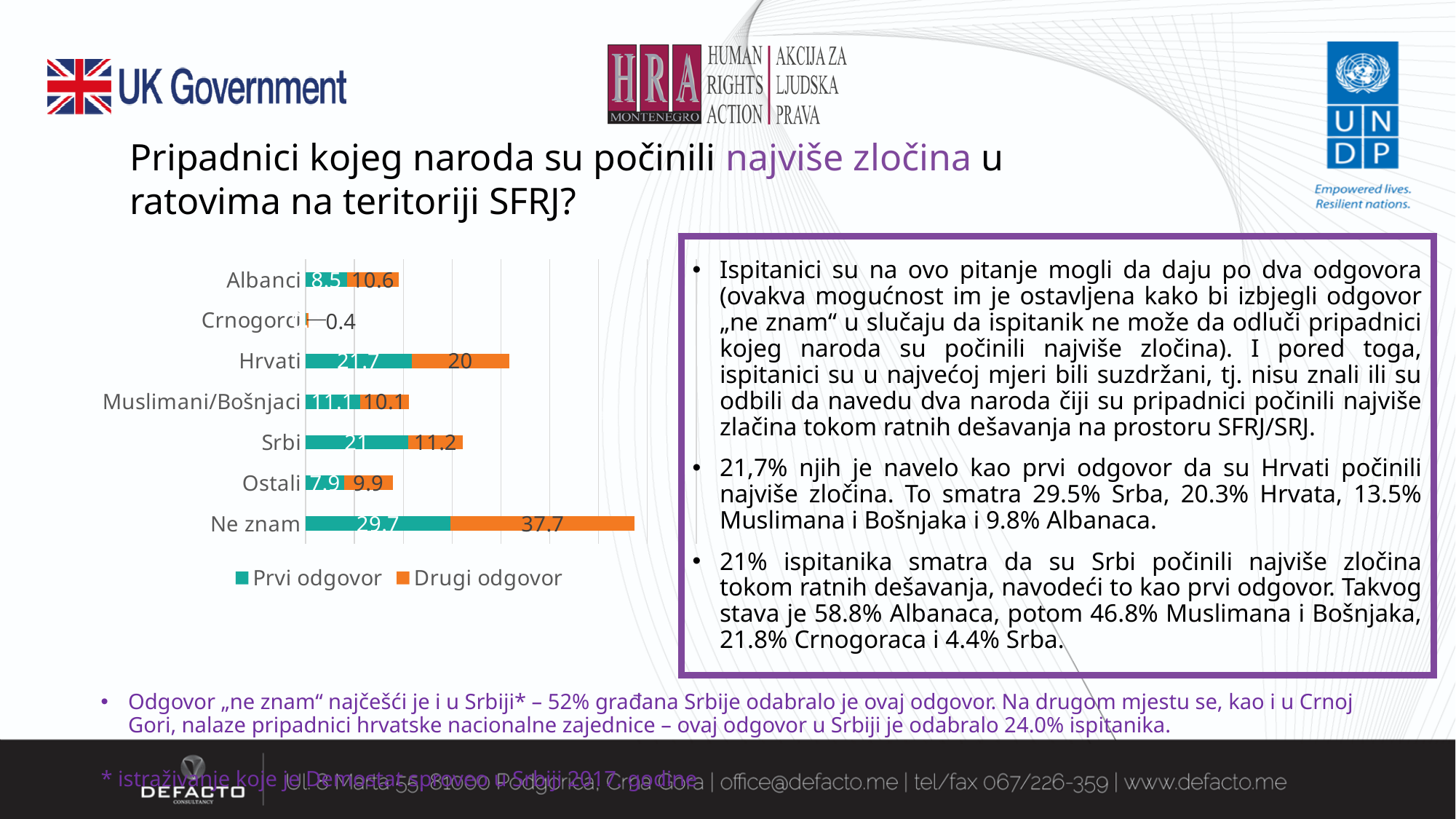
Which category has the lowest Drugi odgovor value? Crnogorci What is the Prvi odgovor value for Hrvati? 21.7 What is the Drugi odgovor value for Ne znam? 37.7 What kind of chart is shown on the slide? Stacked bar chart What is the Drugi odgovor value for Albanci? 10.6 What is the Prvi odgovor value for Srbi? 21 How many series does the legend list? 2 Which category has the highest Prvi odgovor value? Ne znam What is the total of the stacked bar for Hrvati? 41.7 For Ne znam, how much larger is the Drugi odgovor value than the Prvi odgovor value? 8 Which has the larger Prvi odgovor value, Hrvati or Srbi? Hrvati How many categories are shown on the chart? 7